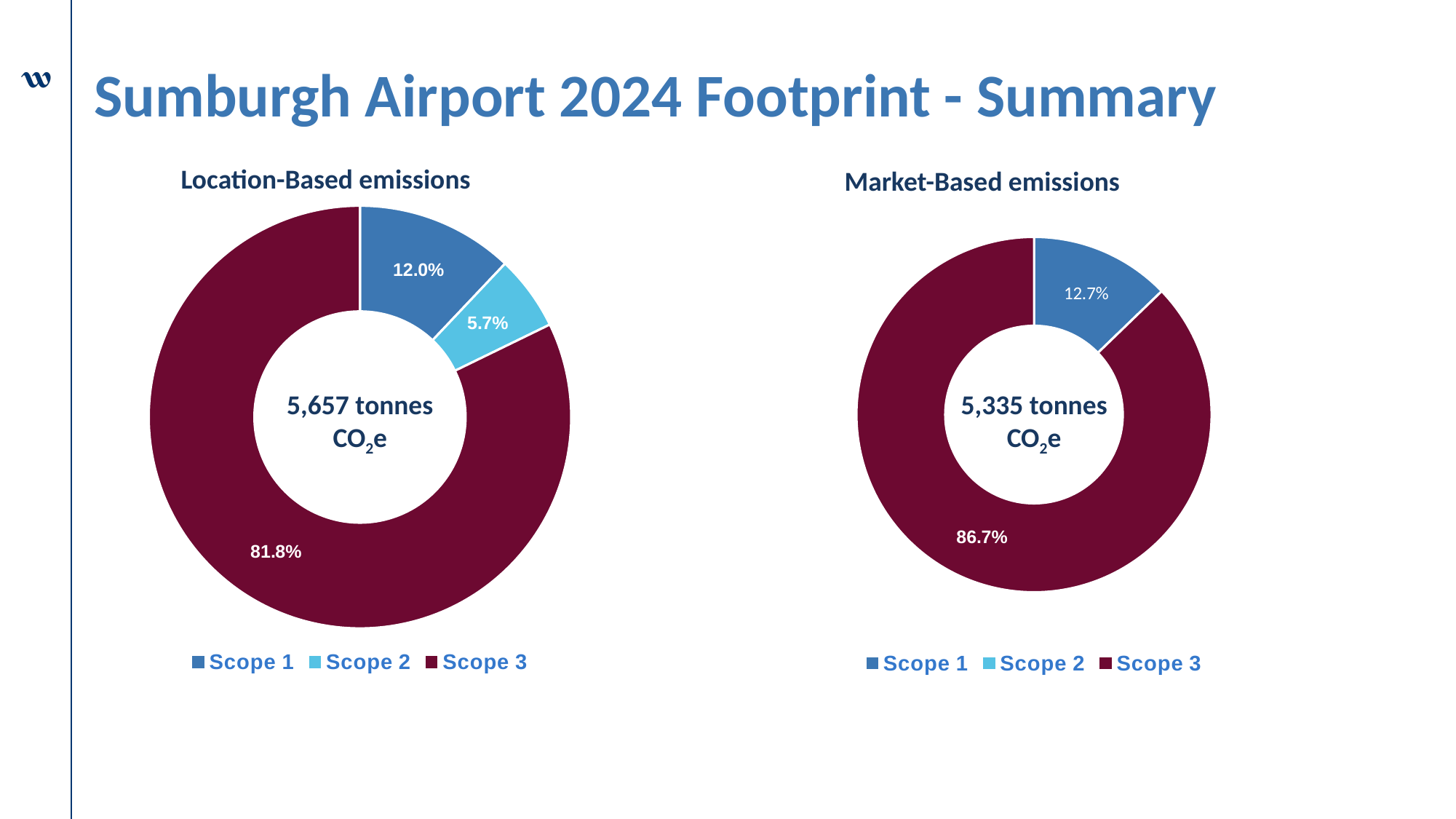
In the Location-Based emissions chart, which scope has the largest share? Scope 3 What kind of chart is the Market-Based emissions chart? Doughnut (pie) chart In the Market-Based emissions chart, what share of emissions is Scope 1? 12.7% In the Market-Based emissions chart, what share of emissions is Scope 3? 86.7% Which chart shows a larger Scope 3 share, Location-Based emissions or Market-Based emissions? Market-Based emissions In the Location-Based emissions chart, what share of emissions is Scope 1? 12.0% In the Location-Based emissions chart, which scope has the smallest share? Scope 2 What total is shown in the centre of the Location-Based emissions chart? 5,657 tonnes CO2e In the Location-Based emissions chart, what share of emissions is Scope 2? 5.7% What total is shown in the centre of the Market-Based emissions chart? 5,335 tonnes CO2e In the Location-Based emissions chart, what share of emissions is Scope 3? 81.8% In the Location-Based emissions chart, what is the difference in percentage points between Scope 1 and Scope 2? 6.3 percentage points